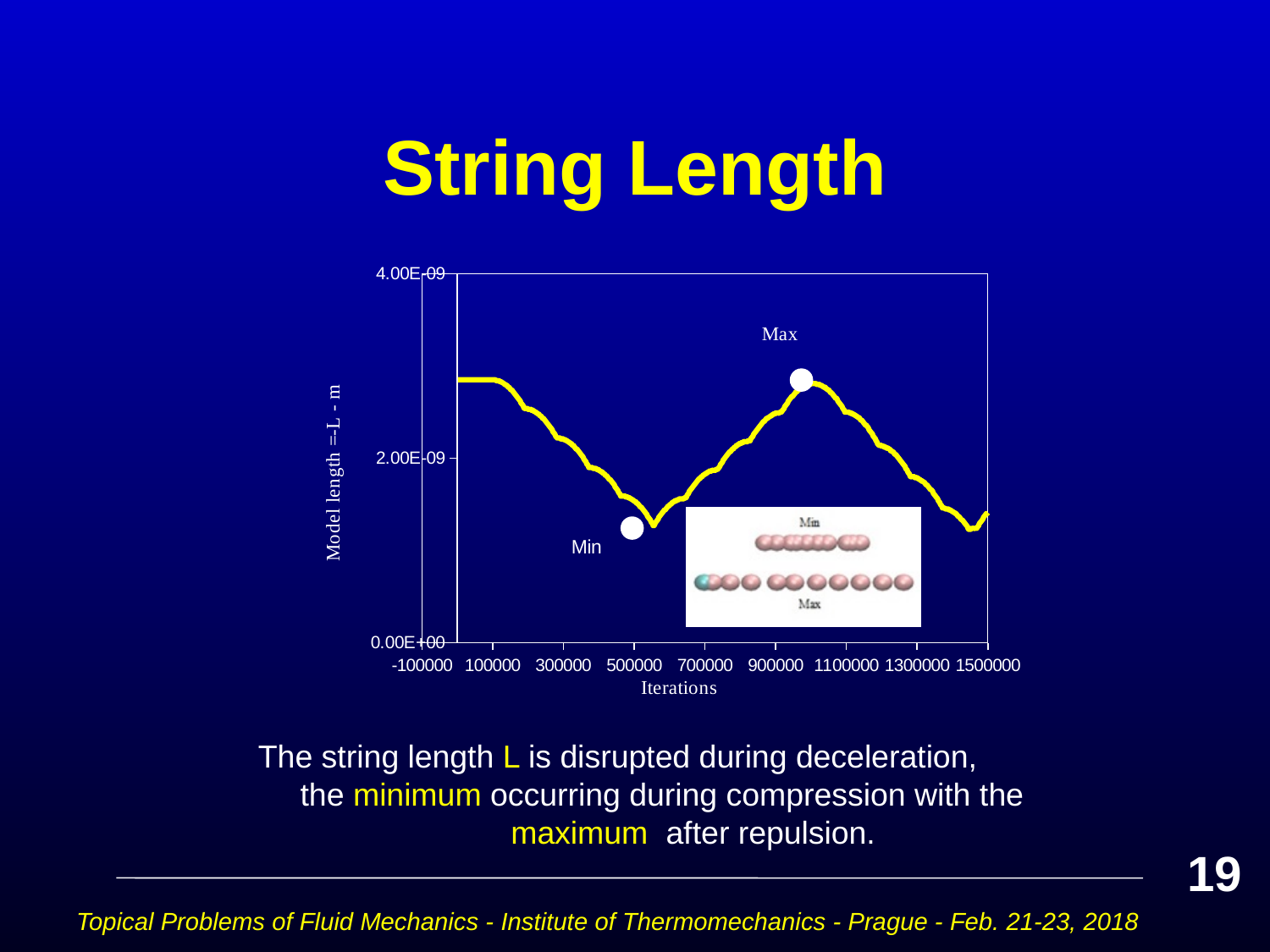
What is the label of the x axis of the chart? Iterations Is the model length at 100000 iterations greater or less than 2.00E-09? greater Which is larger, the model length at the point labelled Max or at the point labelled Min? Max What is the title of the slide containing the chart? String Length Is the model length at 1500000 iterations greater or less than 2.00E-09? less Does the model length rise or fall between 500000 and 900000 iterations? rise What kind of chart is shown on the slide? line chart Does the model length rise or fall between 100000 and 500000 iterations? fall Does the model length rise or fall between 1100000 and 1500000 iterations? fall Is the value at the point labelled Min greater or less than 2.00E-09? less How many data series are plotted in the chart? 1